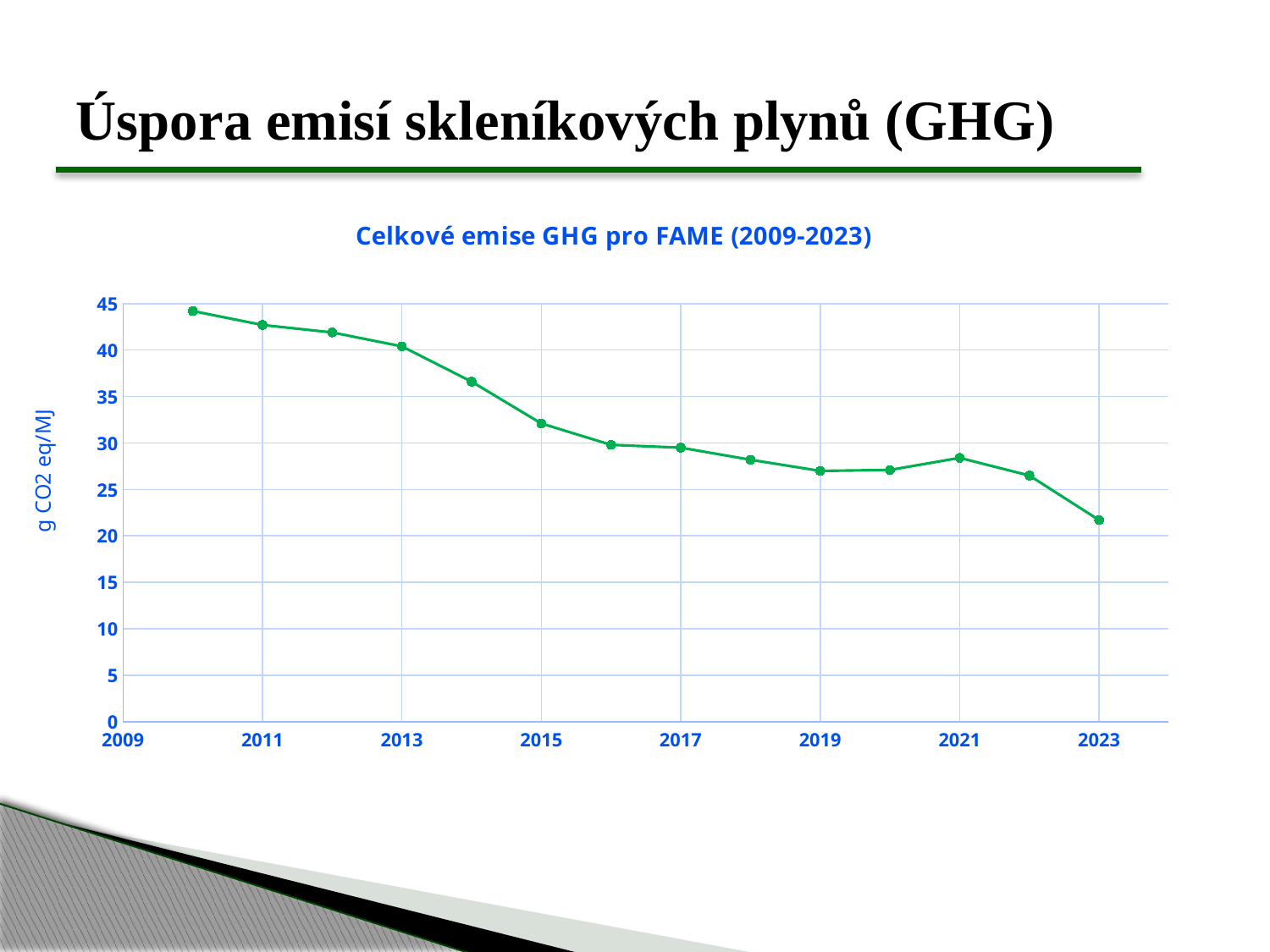
Is the value for 2014 greater or less than 35? greater Is the value for 2023 greater or less than 25? less How many data points are plotted on the line? 14 Which year has the highest value? 2010 Do the values generally rise or fall from 2010 to 2023? fall Which is larger, the value for 2013 or the value for 2015? 2013 Which year has the lowest value? 2023 What is the title of the chart? Celkové emise GHG pro FAME (2009-2023) What kind of chart is shown on the slide? line chart Is the value for 2019 greater or less than 30? less What is the label of the vertical axis? g CO2 eq/MJ